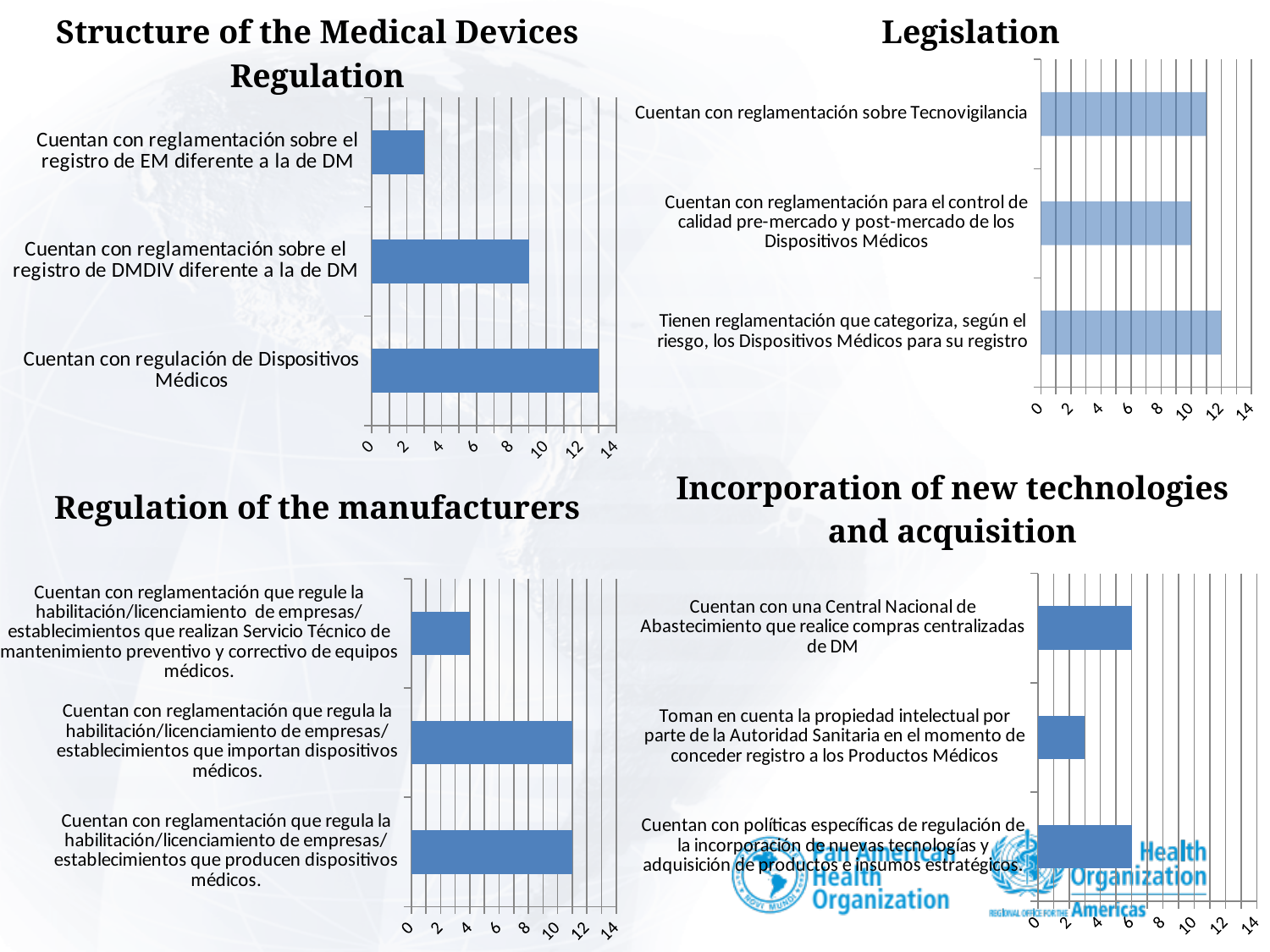
In the 'Structure of the Medical Devices Regulation' chart, which category has the highest value? Cuentan con regulación de Dispositivos Médicos In the 'Incorporation of new technologies and acquisition' chart, which category has the lowest value? Toman en cuenta la propiedad intelectual por parte de la Autoridad Sanitaria en el momento de conceder registro a los Productos Médicos In the 'Incorporation of new technologies and acquisition' chart, which is larger: the value for 'Cuentan con una Central Nacional de Abastecimiento que realice compras centralizadas de DM' or the value for 'Toman en cuenta la propiedad intelectual por parte de la Autoridad Sanitaria en el momento de conceder registro a los Productos Médicos'? Cuentan con una Central Nacional de Abastecimiento que realice compras centralizadas de DM In the 'Incorporation of new technologies and acquisition' chart, is the value for 'Cuentan con una Central Nacional de Abastecimiento que realice compras centralizadas de DM' greater or less than 4? greater In the 'Structure of the Medical Devices Regulation' chart, which category has the lowest value? Cuentan con reglamentación sobre el registro de EM diferente a la de DM In the 'Structure of the Medical Devices Regulation' chart, is the value for 'Cuentan con reglamentación sobre el registro de EM diferente a la de DM' greater or less than 4? less In the 'Regulation of the manufacturers' chart, is the value for the category about companies that import medical devices ('importan dispositivos médicos') greater or less than 10? greater How many categories does the 'Legislation' chart show? 3 What kind of chart is the 'Structure of the Medical Devices Regulation' chart? Bar chart In the 'Regulation of the manufacturers' chart, which category has the lowest value? Cuentan con reglamentación que regule la habilitación/licenciamiento de empresas/establecimientos que realizan Servicio Técnico de mantenimiento preventivo y correctivo de equipos médicos. How many charts are shown on the slide? 4